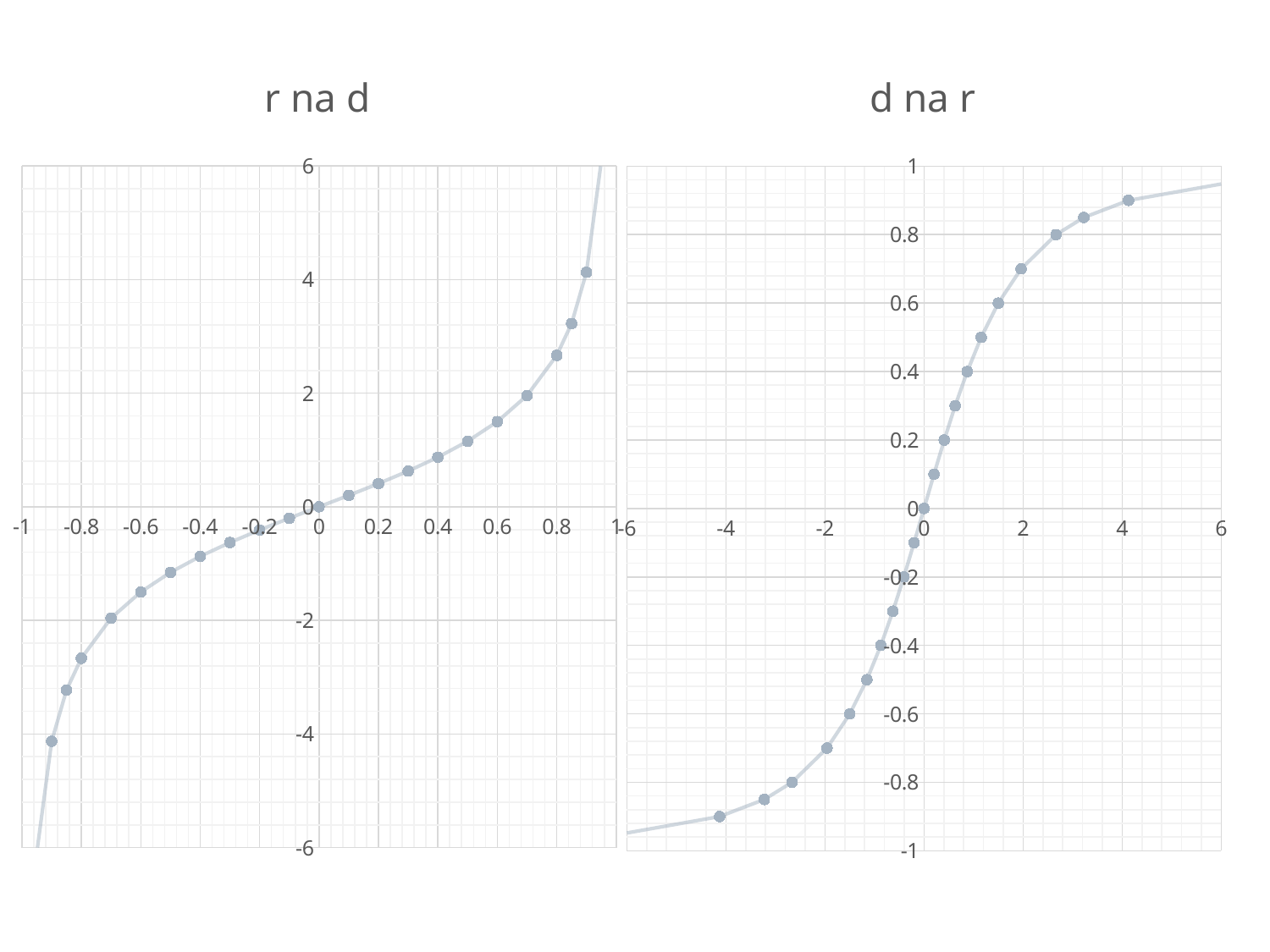
In the 'd na r' chart, is the value at x = 4 greater or less than 0.8? greater What is the title of the chart on the right? d na r In the 'r na d' chart, is the value at x = 0.8 greater or less than 2? greater In the 'd na r' chart, is the value at x = -2 greater or less than -0.6? less In the 'r na d' chart, which is larger, the value at x = 0.8 or the value at x = 0.4? the value at x = 0.8 In the 'd na r' chart, do the values rise or fall as x increases from -6 to 6? rise In the 'd na r' chart, which is larger, the value at x = 2 or the value at x = -2? the value at x = 2 In the 'r na d' chart, do the values rise or fall as x increases from -1 to 1? rise In the 'r na d' chart, what kind of chart is shown? scatter chart What is the title of the chart on the left? r na d